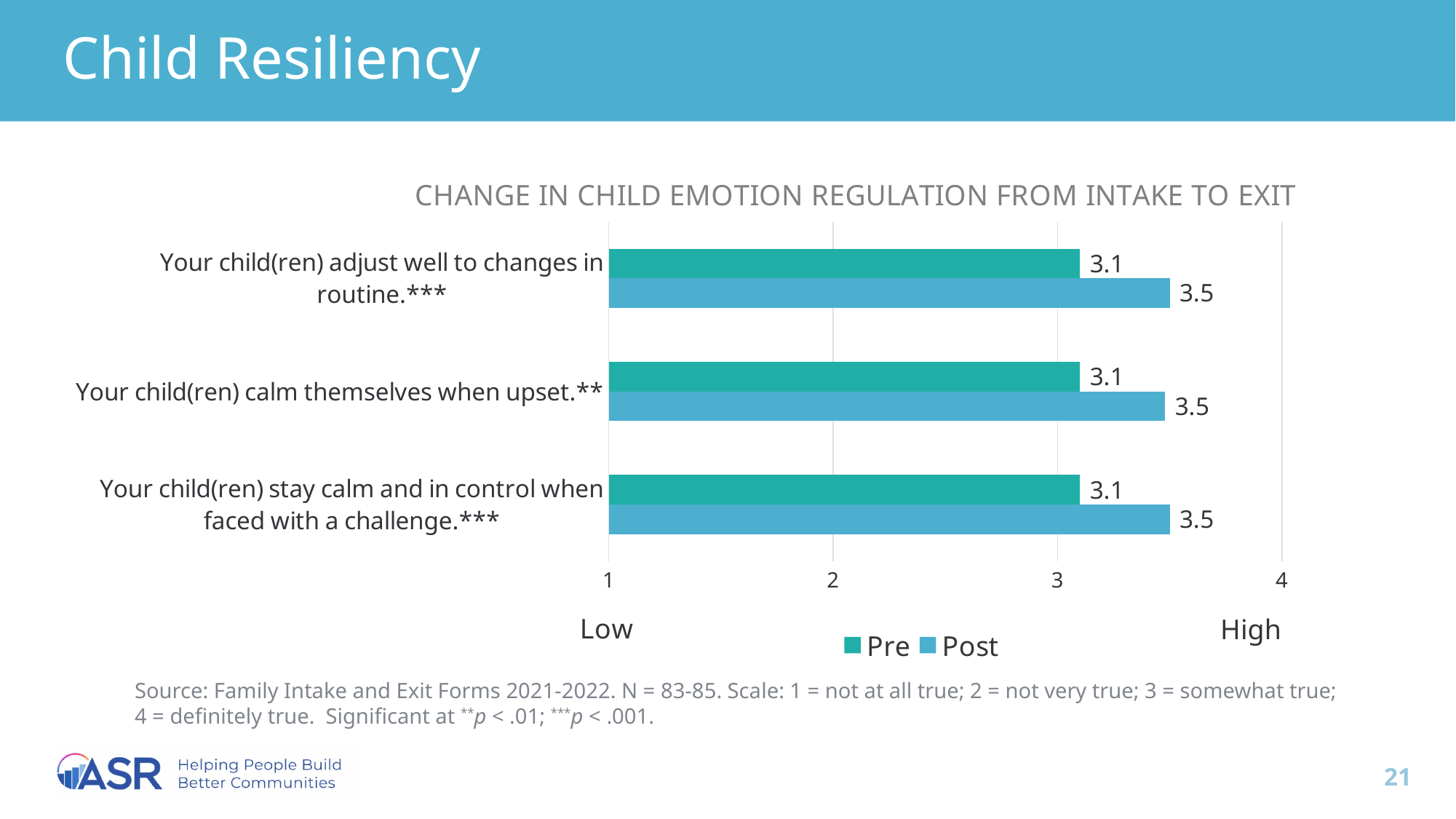
What is the Post value for "Your child(ren) stay calm and in control when faced with a challenge"? 3.5 What kind of chart is shown on the slide? Bar chart Which series is shown in the lighter blue colour in the legend? Post What is the title of the chart? Change in Child Emotion Regulation from Intake to Exit What is the Pre value for "Your child(ren) stay calm and in control when faced with a challenge"? 3.1 How many categories (survey items) are shown in the chart? 3 What is the Post value for "Your child(ren) calm themselves when upset"? 3.5 What is the difference between the Post and Pre values for "Your child(ren) calm themselves when upset"? 0.4 How many series does the legend list? 2 Which is larger for "Your child(ren) adjust well to changes in routine": the Pre value or the Post value? Post What is the Pre value for "Your child(ren) adjust well to changes in routine"? 3.1 Is the Post value for "Your child(ren) stay calm and in control when faced with a challenge" greater or less than 3? greater